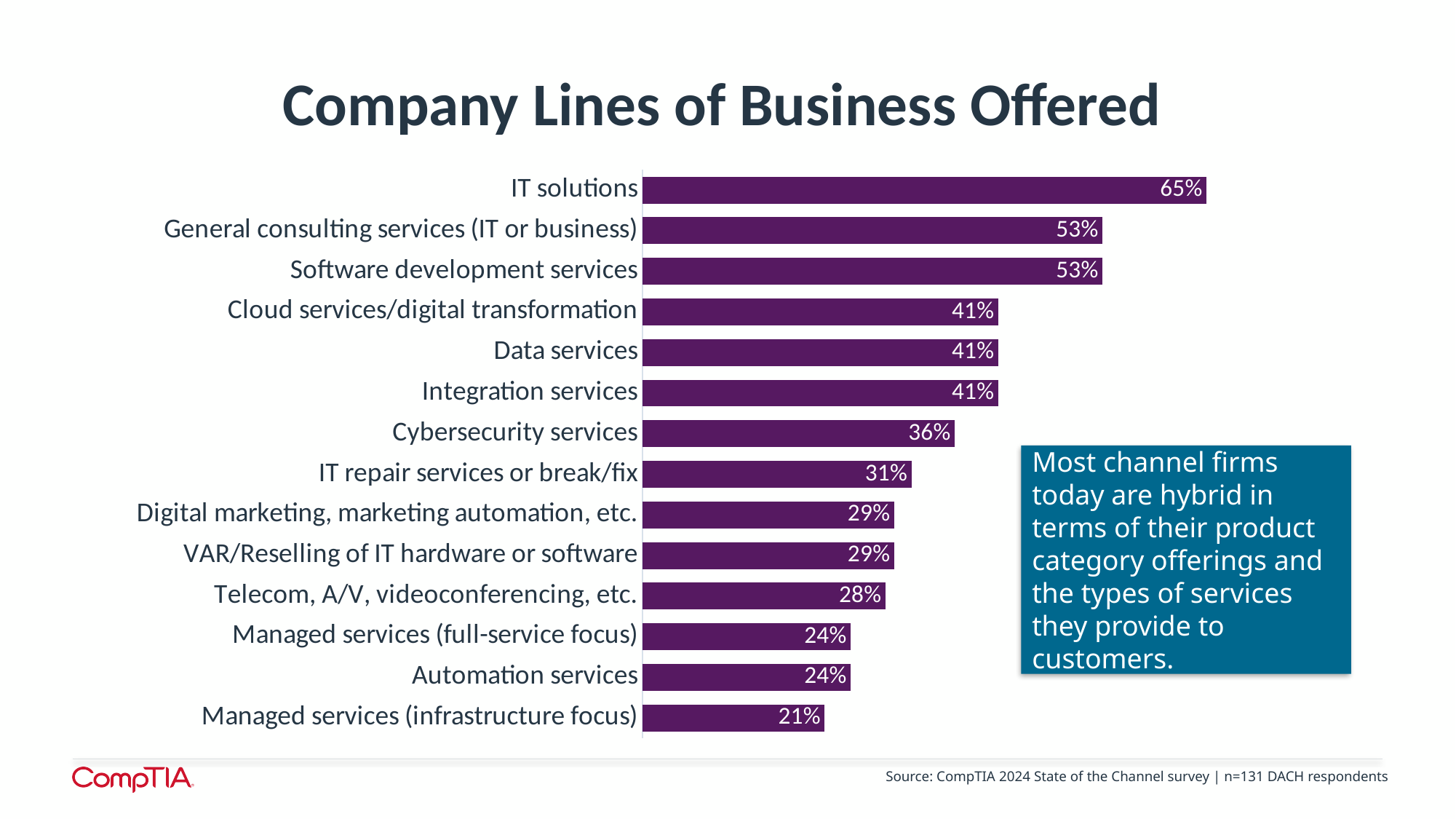
Which is larger: Data services or Digital marketing, marketing automation, etc.? Data services What is the title of the chart? Company Lines of Business Offered How many lines of business are shown in the chart? 14 What is the difference between Cybersecurity services and Telecom, A/V, videoconferencing, etc.? 8% What kind of chart is shown on the slide? Bar chart What percentage of companies offer IT solutions? 65% Which line of business has the lowest percentage? Managed services (infrastructure focus) What is the value for IT repair services or break/fix? 31% Which line of business has the highest percentage? IT solutions What is the difference between IT solutions and Software development services? 12% What percentage is shown for Managed services (infrastructure focus)? 21% What is the value for Cybersecurity services? 36%